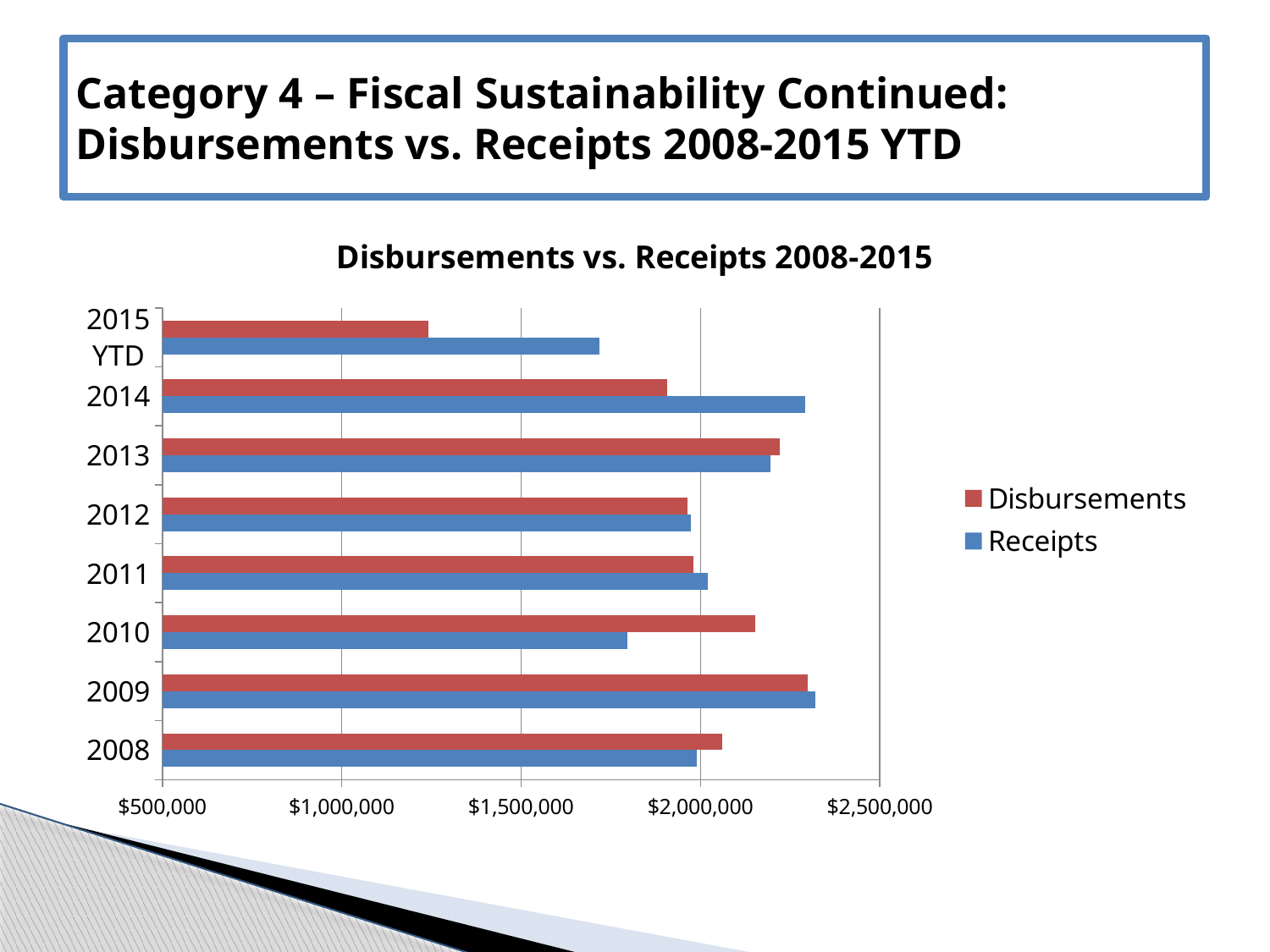
Is the Disbursements value for 2015 YTD greater or less than $1,500,000? less Which year has the highest Disbursements value? 2009 Is the Receipts value for 2014 greater or less than $2,000,000? greater In 2015 YTD, which is larger, Disbursements or Receipts? Receipts How many year categories are shown on the chart? 8 Is the Receipts value for 2010 greater or less than $2,000,000? less In 2010, which is larger, Disbursements or Receipts? Disbursements What kind of chart is shown on the slide? bar chart How many series does the legend list? 2 Which year has the lowest Receipts value? 2015 YTD Which year has the lowest Disbursements value? 2015 YTD What is the title of the chart? Disbursements vs. Receipts 2008-2015